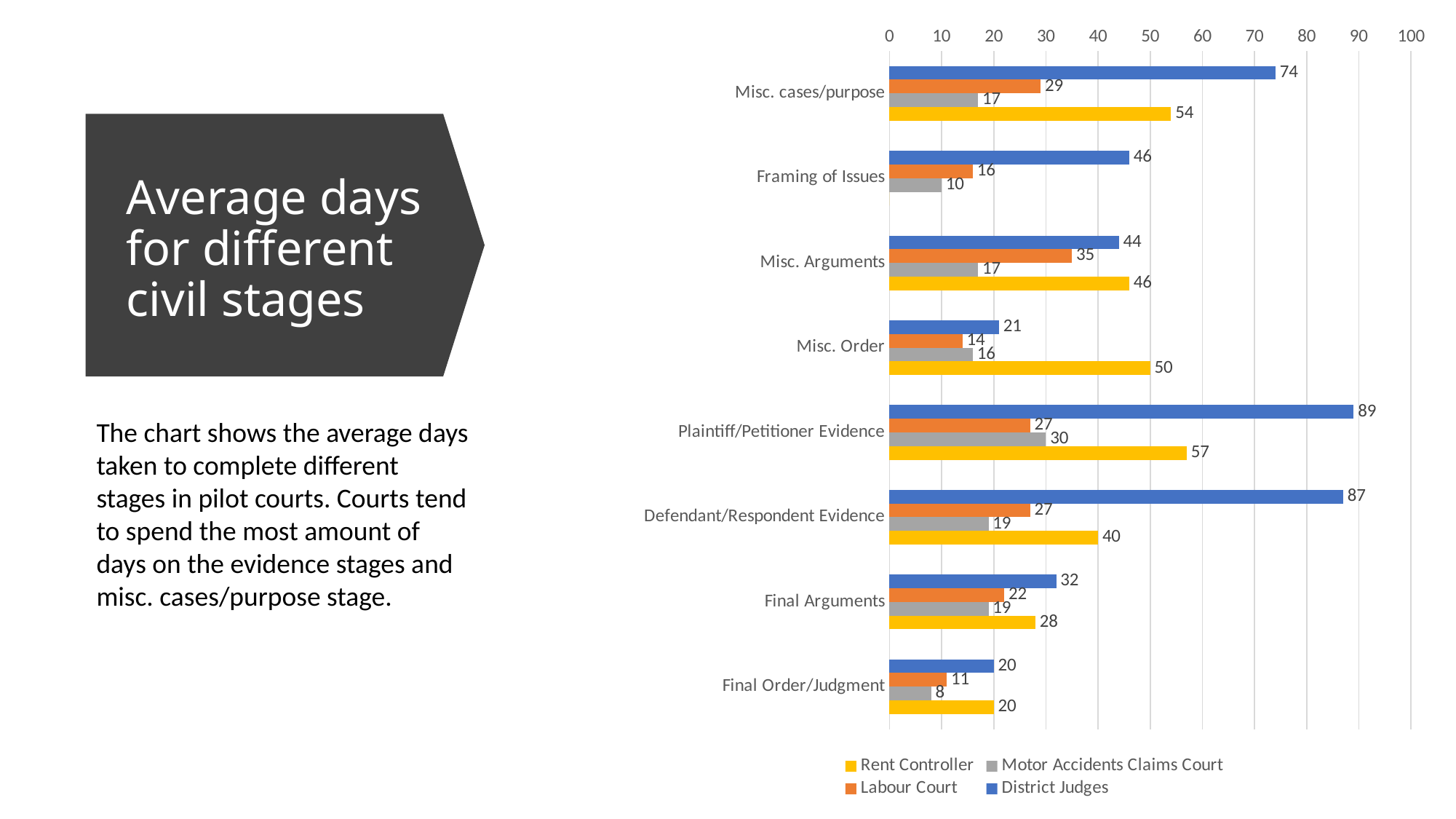
What is the value for District Judges at the Plaintiff/Petitioner Evidence stage? 89 What is the value for Motor Accidents Claims Court at the Final Order/Judgment stage? 8 At the Defendant/Respondent Evidence stage, which is larger: the Labour Court value or the Motor Accidents Claims Court value? Labour Court Which stage has the highest value for District Judges? Plaintiff/Petitioner Evidence How many series does the legend list? 4 What kind of chart is shown on the slide? Bar chart What is the value for Rent Controller at the Misc. Order stage? 50 Which stage has the lowest value for Motor Accidents Claims Court? Final Order/Judgment What is the difference between the District Judges value and the Rent Controller value at the Misc. cases/purpose stage? 20 What is the value for Labour Court at the Misc. Arguments stage? 35 How many stages (categories) are shown on the chart? 8 Which colour represents District Judges in the chart? Blue